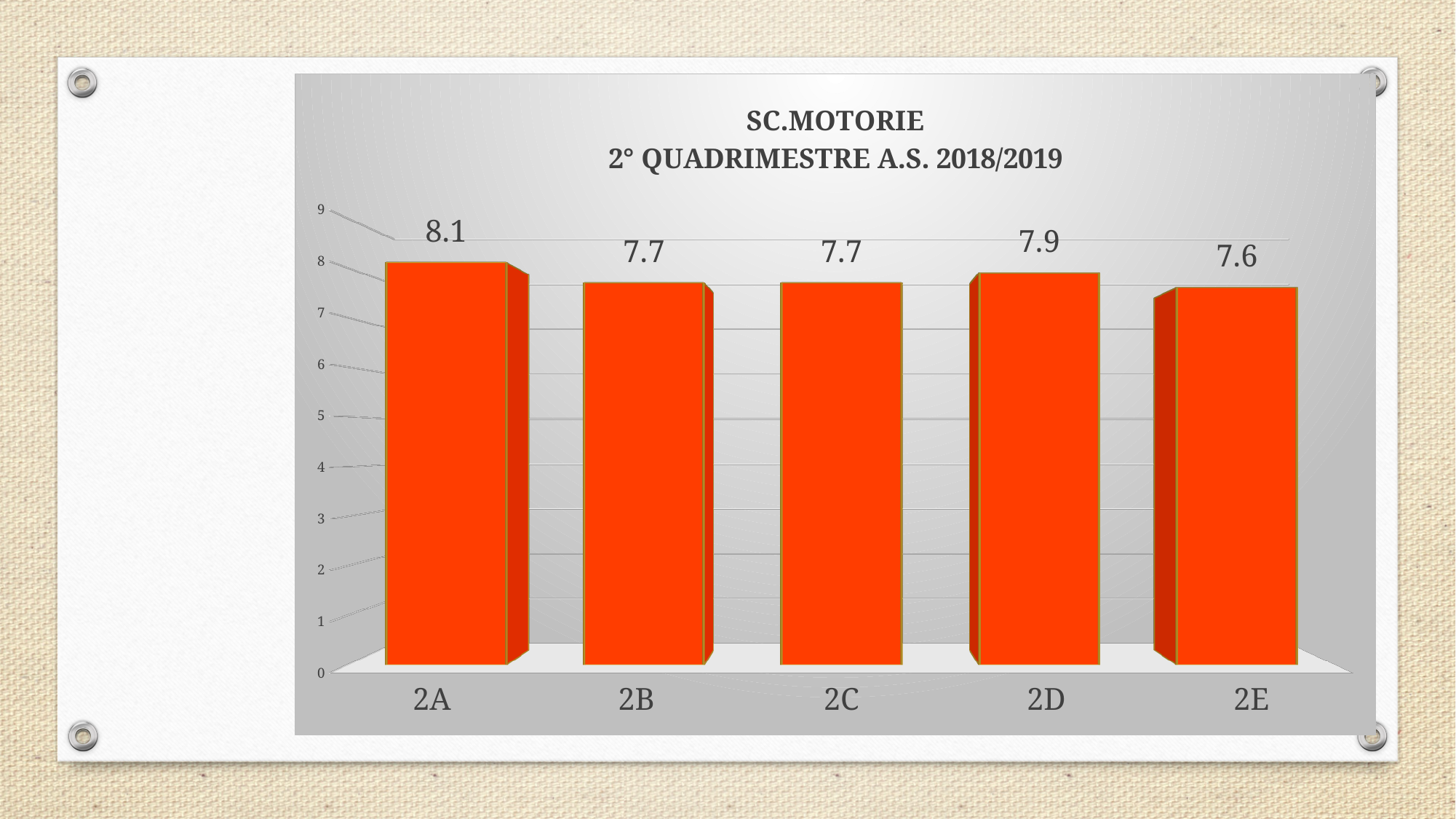
What is the difference between the values for 2D and 2B? 0.2 What is the difference between the values for 2A and 2E? 0.5 What kind of chart is shown on the slide? bar chart Which is larger, the value for 2A or the value for 2D? 2A Is the value for 2A greater or less than 8? greater What is the title of the chart? SC.MOTORIE 2° QUADRIMESTRE A.S. 2018/2019 Which category has the lowest value? 2E How many categories are shown on the x axis? 5 Which category has the highest value? 2A What is the value for 2A? 8.1 What is the value for 2D? 7.9 What is the value for 2E? 7.6